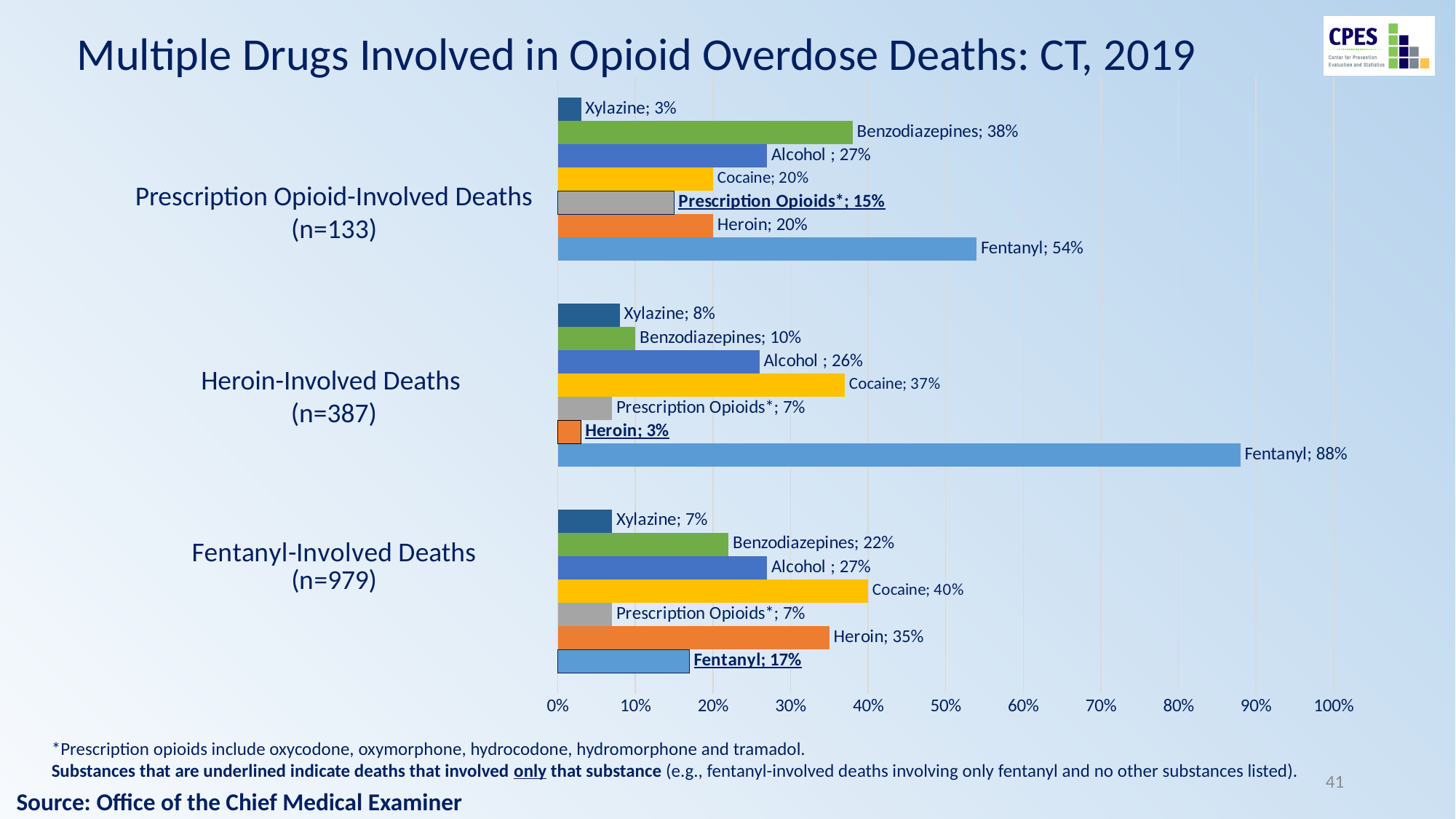
What percentage of Prescription Opioid-Involved Deaths involved Benzodiazepines? 38% How many death groups are shown on the chart? 3 What is the sample size (n) for Fentanyl-Involved Deaths? 979 What percentage of Fentanyl-Involved Deaths involved Cocaine? 40% What is the title of the chart? Multiple Drugs Involved in Opioid Overdose Deaths: CT, 2019 What percentage of Heroin-Involved Deaths involved Fentanyl? 88% What kind of chart is shown on the slide? Bar chart Which substance has the highest percentage among Prescription Opioid-Involved Deaths? Fentanyl Among Heroin-Involved Deaths, which is larger: the Cocaine percentage or the Alcohol percentage? Cocaine How many substance categories are shown for each death group? 7 What is the difference between the Heroin percentage and the Xylazine percentage among Fentanyl-Involved Deaths? 28% Which substance has the lowest percentage among Heroin-Involved Deaths? Heroin